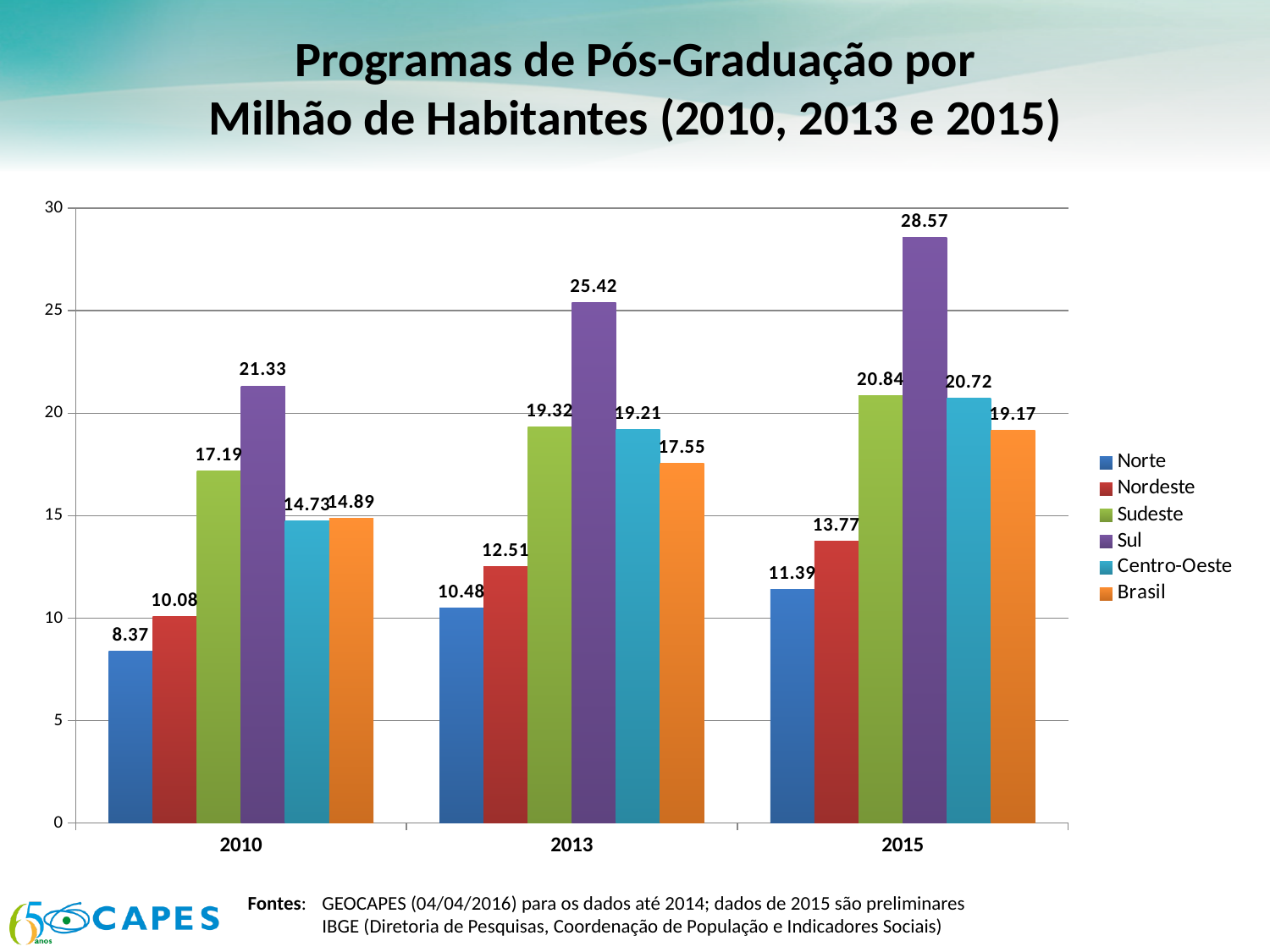
Which is larger in 2010: the value for Centro-Oeste or the value for Brasil? Brasil Which region has the lowest value in 2015? Norte What kind of chart is shown on the slide? bar chart Which region has the highest value in 2013? Sul How many series does the legend list? 6 What is the value for Sul in 2015? 28.57 What is the difference between the Sul value in 2015 and the Sul value in 2010? 7.24 Is the value for Sudeste in 2015 greater or less than 20? greater Does the value for Nordeste rise or fall from 2010 to 2015? rise How many year groups are shown on the x axis? 3 What is the value for Norte in 2010? 8.37 What is the value for Brasil in 2013? 17.55